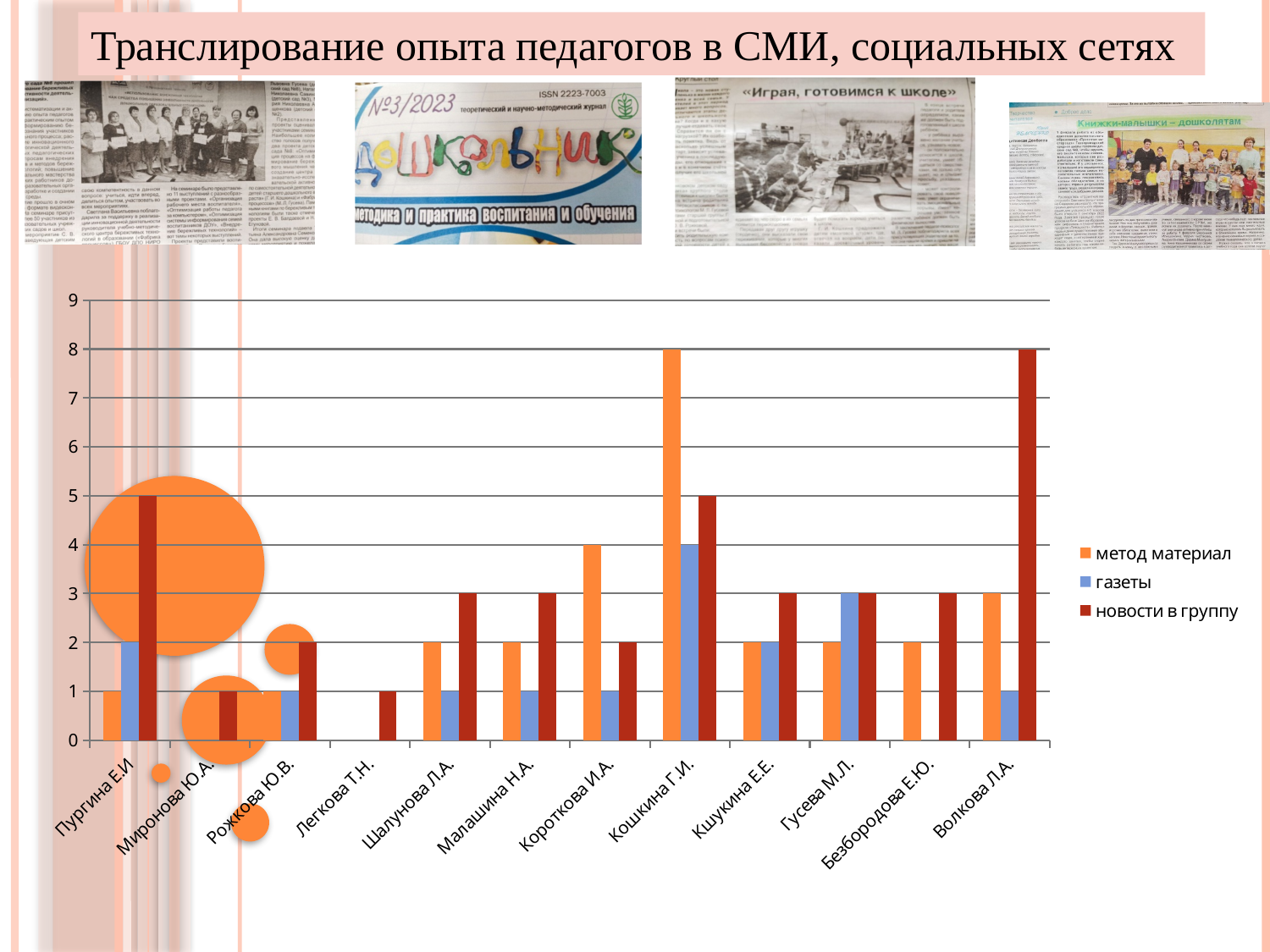
What is the difference between the "метод материал" value for Кошкина Г.И. and the "метод материал" value for Короткова И.А.? 4 What is the value of "новости в группу" for Волкова Л.А.? 8 What kind of chart is shown on the slide? bar chart What is the value of "метод материал" for Короткова И.А.? 4 How many teachers (categories) are shown on the x axis of the chart? 12 Which teacher has the highest value for "газеты"? Кошкина Г.И. What is the value of "газеты" for Кошкина Г.И.? 4 What is the value of "метод материал" for Кошкина Г.И.? 8 How many series does the chart legend list? 3 Which teacher has the highest value for "метод материал"? Кошкина Г.И. Which series in the legend is shown in orange? метод материал Which is larger: the "новости в группу" value for Волкова Л.А. or the "новости в группу" value for Кошкина Г.И.? Волкова Л.А.